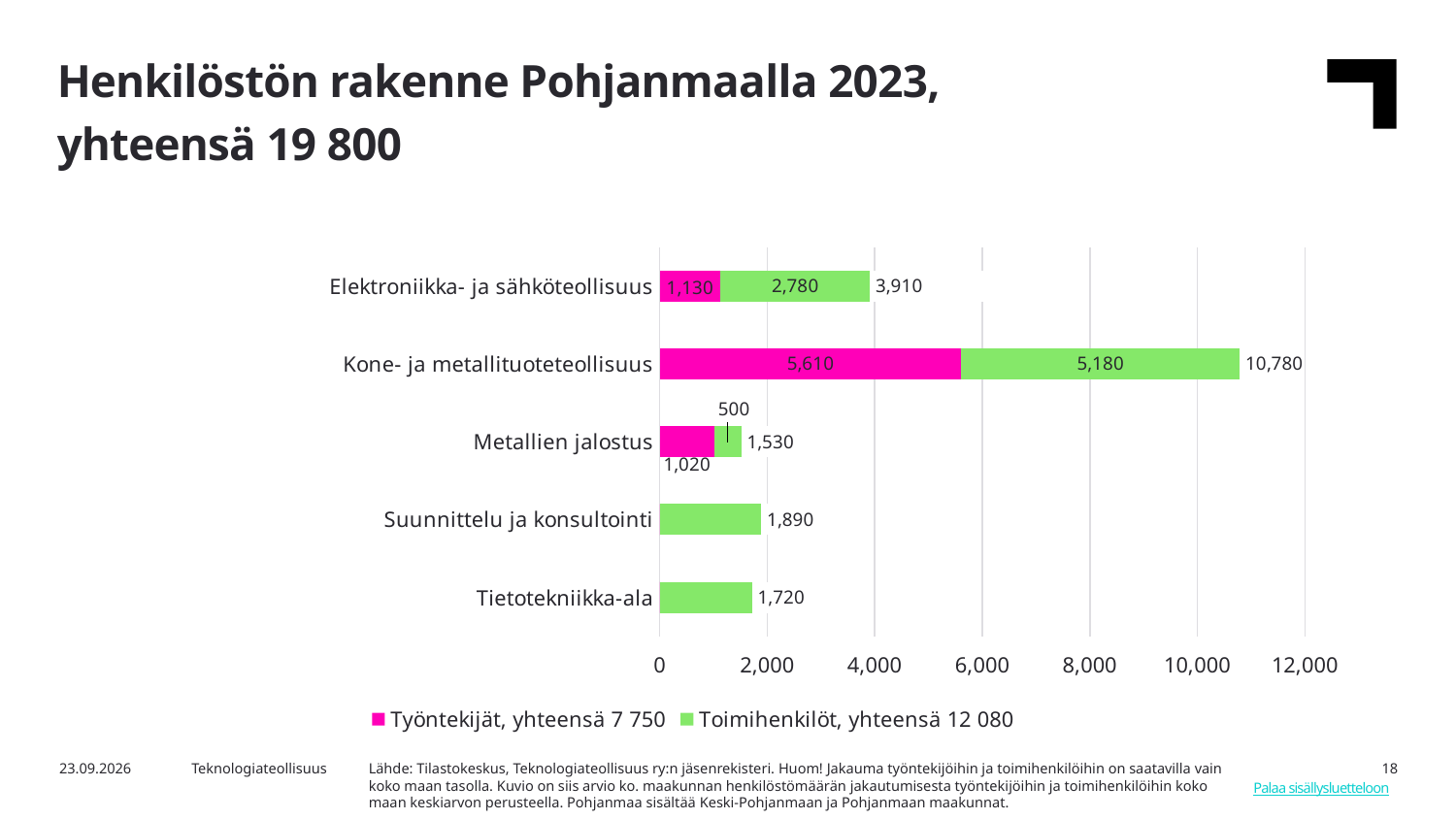
Is the total for Elektroniikka- ja sähköteollisuus greater or less than 4,000? less What is the difference between the Työntekijät and Toimihenkilöt values for Kone- ja metallituoteteollisuus? 430 Which category has the highest total? Kone- ja metallituoteteollisuus How many categories are shown on the chart? 5 Which category has the lowest total? Metallien jalostus What is the Toimihenkilöt value for Elektroniikka- ja sähköteollisuus? 2,780 What kind of chart is shown on the slide? Stacked bar chart What is the Työntekijät value for Kone- ja metallituoteteollisuus? 5,610 What is the total value shown for Metallien jalostus? 1,530 What total is given in the legend for Toimihenkilöt? 12 080 Which is larger: the total for Suunnittelu ja konsultointi or the total for Tietotekniikka-ala? Suunnittelu ja konsultointi How many series does the legend list? 2